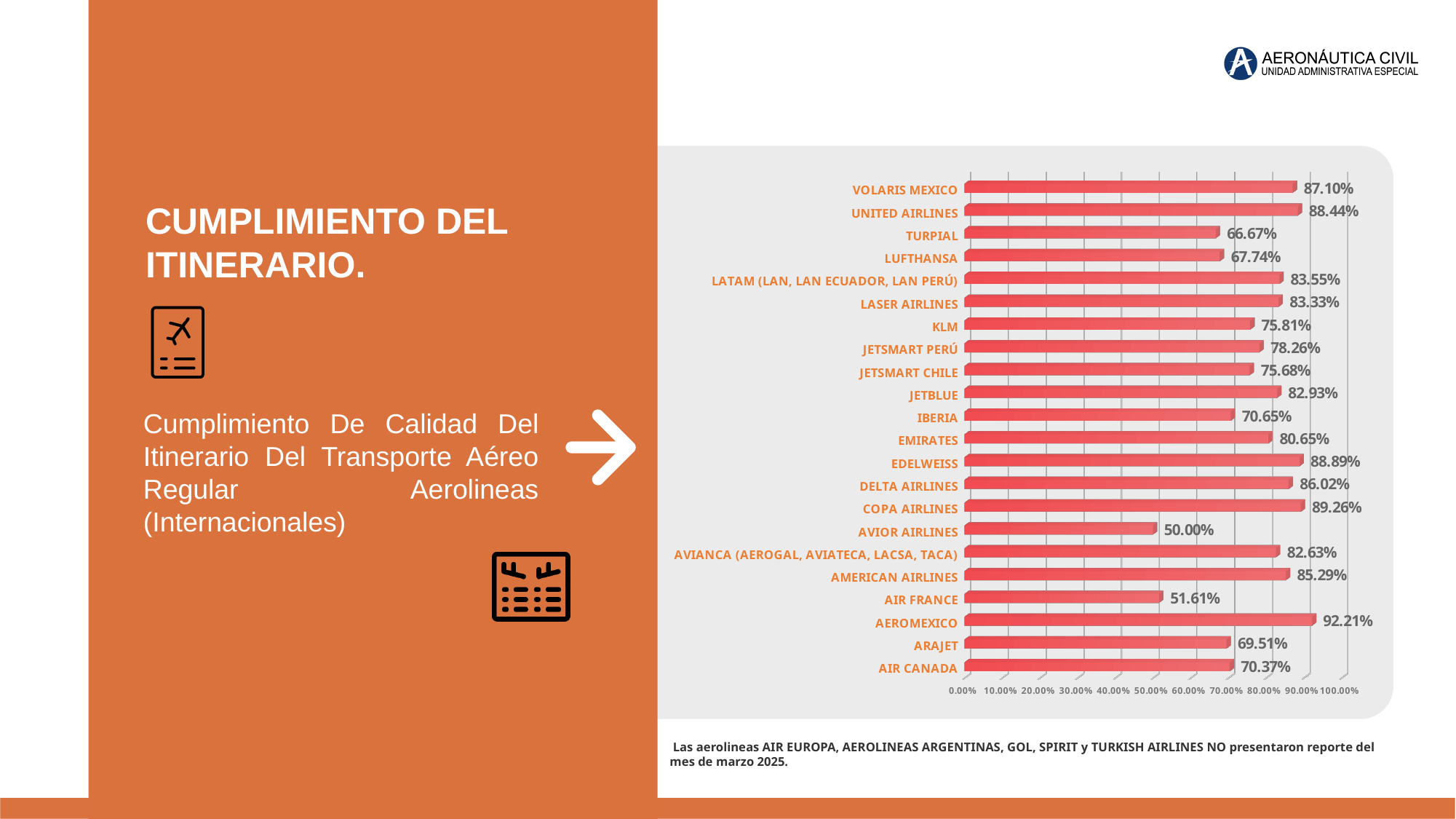
What is the value for AEROMEXICO? 92.21% Is the value for KLM greater or less than 80.00%? less What kind of chart is shown on the slide? bar chart Which has a larger value, LUFTHANSA or TURPIAL? LUFTHANSA What is the value for AVIOR AIRLINES? 50.00% What is the difference between the values for AEROMEXICO and AVIOR AIRLINES? 42.21% What is the value for LATAM (LAN, LAN ECUADOR, LAN PERÚ)? 83.55% Which airline has the highest value? AEROMEXICO What is the value for JETSMART CHILE? 75.68% How many airlines are shown in the chart? 22 Which airline has the lowest value? AVIOR AIRLINES What is the difference between the values for COPA AIRLINES and DELTA AIRLINES? 3.24%